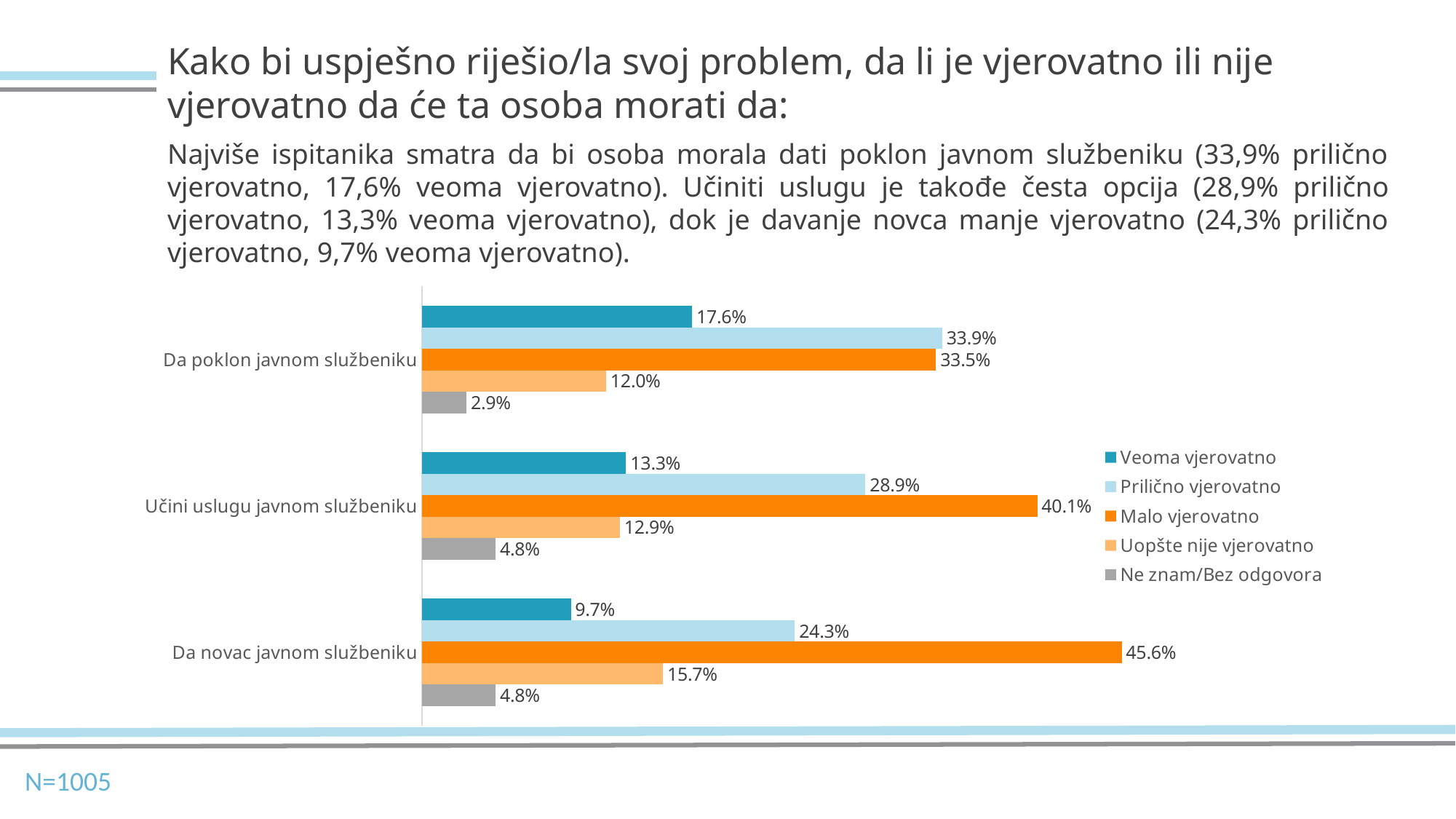
What is the total of the "Veoma vjerovatno" and "Prilično vjerovatno" values for "Da novac javnom službeniku"? 34.0% Which category has the highest value for "Malo vjerovatno"? Da novac javnom službeniku Which category has the lowest value for "Ne znam/Bez odgovora"? Da poklon javnom službeniku What is the value for "Malo vjerovatno" for "Da novac javnom službeniku"? 45.6% How many series does the legend list? 5 What is the difference between the "Prilično vjerovatno" values for "Da poklon javnom službeniku" and "Da novac javnom službeniku"? 9.6% Which is larger for "Učini uslugu javnom službeniku": "Veoma vjerovatno" or "Prilično vjerovatno"? Prilično vjerovatno Which series is shown in dark orange in the legend? Malo vjerovatno What kind of chart is shown on the slide? Bar chart What is the value for "Veoma vjerovatno" for "Da poklon javnom službeniku"? 17.6% How many categories are shown on the chart? 3 What is the value for "Uopšte nije vjerovatno" for "Učini uslugu javnom službeniku"? 12.9%